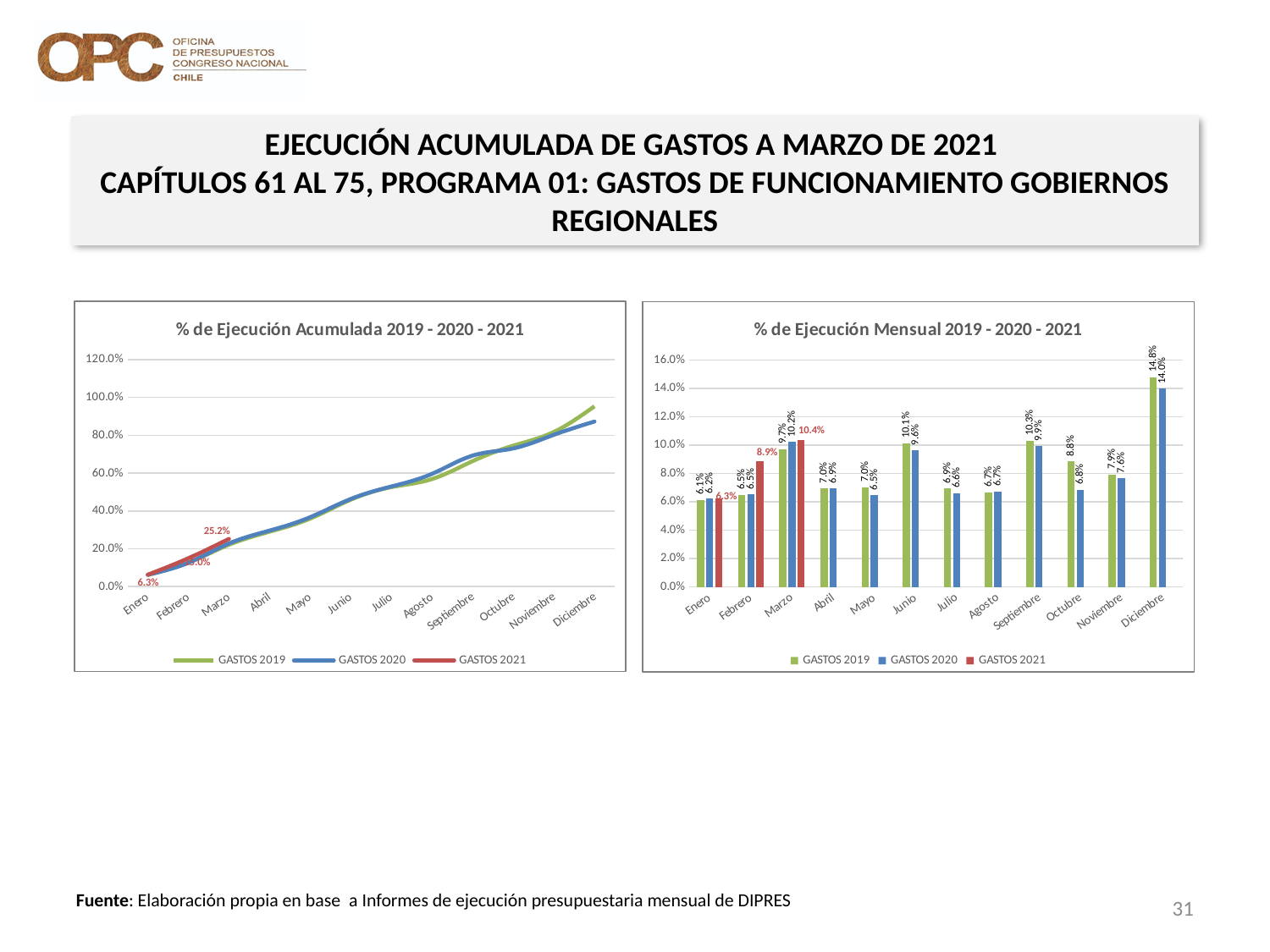
What kind of chart is the '% de Ejecución Mensual 2019 - 2020 - 2021' chart on the right? bar chart In the '% de Ejecución Mensual 2019 - 2020 - 2021' chart, what is the value for GASTOS 2019 in Diciembre? 14.8% In the '% de Ejecución Mensual 2019 - 2020 - 2021' chart, which month has the highest value for GASTOS 2019? Diciembre In the '% de Ejecución Mensual 2019 - 2020 - 2021' chart, what is the difference between GASTOS 2019 and GASTOS 2020 in Octubre? 2.0 percentage points What kind of chart is the '% de Ejecución Acumulada 2019 - 2020 - 2021' chart on the left? line chart In the '% de Ejecución Acumulada 2019 - 2020 - 2021' chart, is the value for GASTOS 2019 in Diciembre greater or less than 80.0%? greater In the '% de Ejecución Acumulada 2019 - 2020 - 2021' chart, what is the value for GASTOS 2021 in Marzo? 25.2% In the '% de Ejecución Mensual 2019 - 2020 - 2021' chart, what is the value for GASTOS 2021 in Marzo? 10.4% In the '% de Ejecución Mensual 2019 - 2020 - 2021' chart, how many series does the legend list? 3 In the '% de Ejecución Mensual 2019 - 2020 - 2021' chart, which is larger in Junio, GASTOS 2019 or GASTOS 2020? GASTOS 2019 In the '% de Ejecución Mensual 2019 - 2020 - 2021' chart, how many months are shown on the x axis? 12 In the '% de Ejecución Acumulada 2019 - 2020 - 2021' chart, do the GASTOS 2020 values rise or fall from Enero to Diciembre? rise